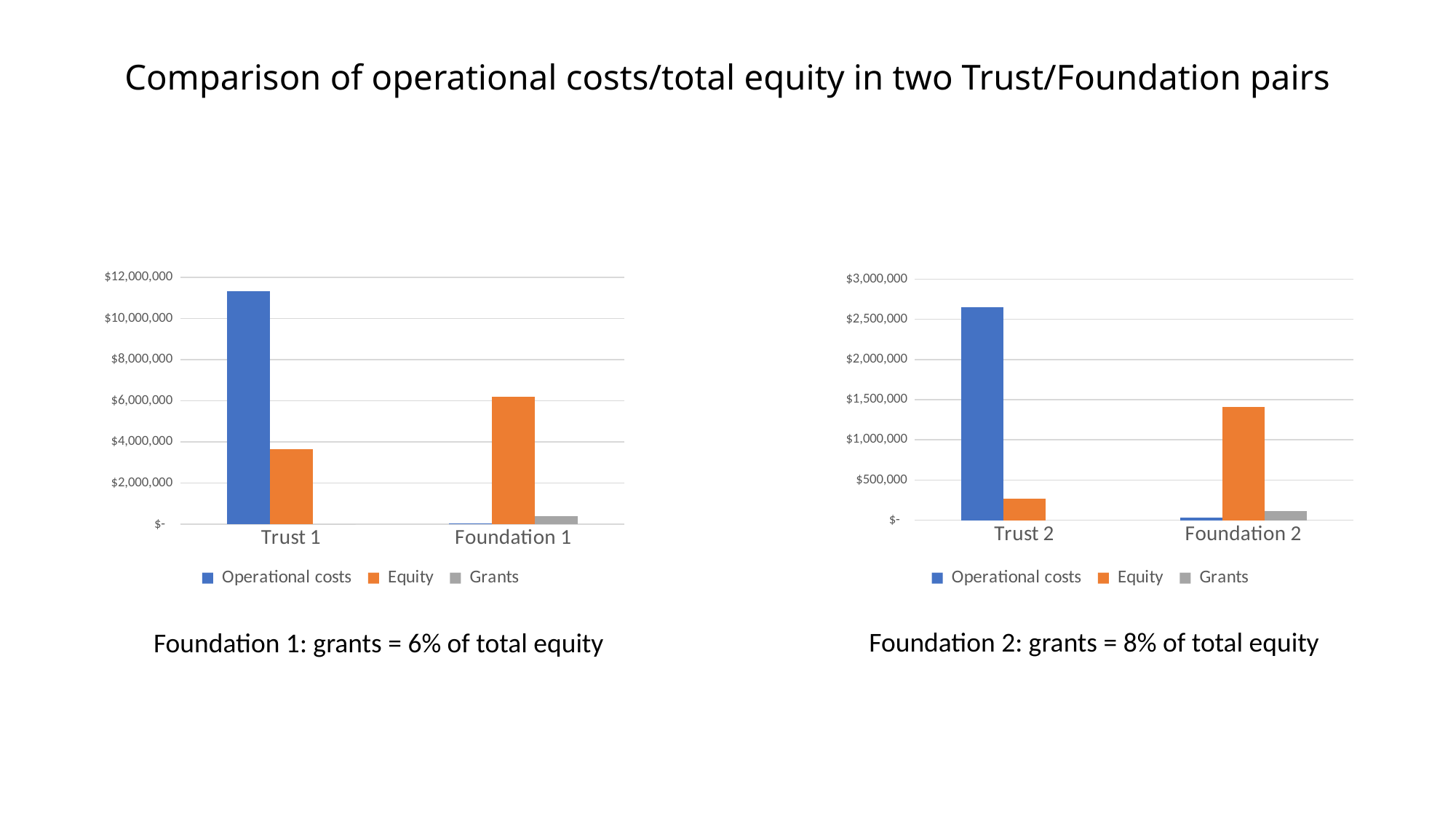
In the left chart, is the Operational costs value for Trust 1 greater or less than $10,000,000? greater How many categories are shown on the x axis of the left chart (Trust 1 / Foundation 1)? 2 What colour are the Equity bars in both charts? orange In the right chart, is the Operational costs value for Trust 2 greater or less than $2,500,000? greater In the right chart, which series has the smallest bar for Foundation 2? Operational costs In the right chart, is the Equity value for Foundation 2 greater or less than $1,500,000? less In the left chart, which series has the tallest bar for Foundation 1? Equity What kind of chart is the left chart (Trust 1 / Foundation 1)? bar chart In the right chart, which is larger for Trust 2: Operational costs or Equity? Operational costs How many series does the legend of the right chart (Trust 2 / Foundation 2) list? 3